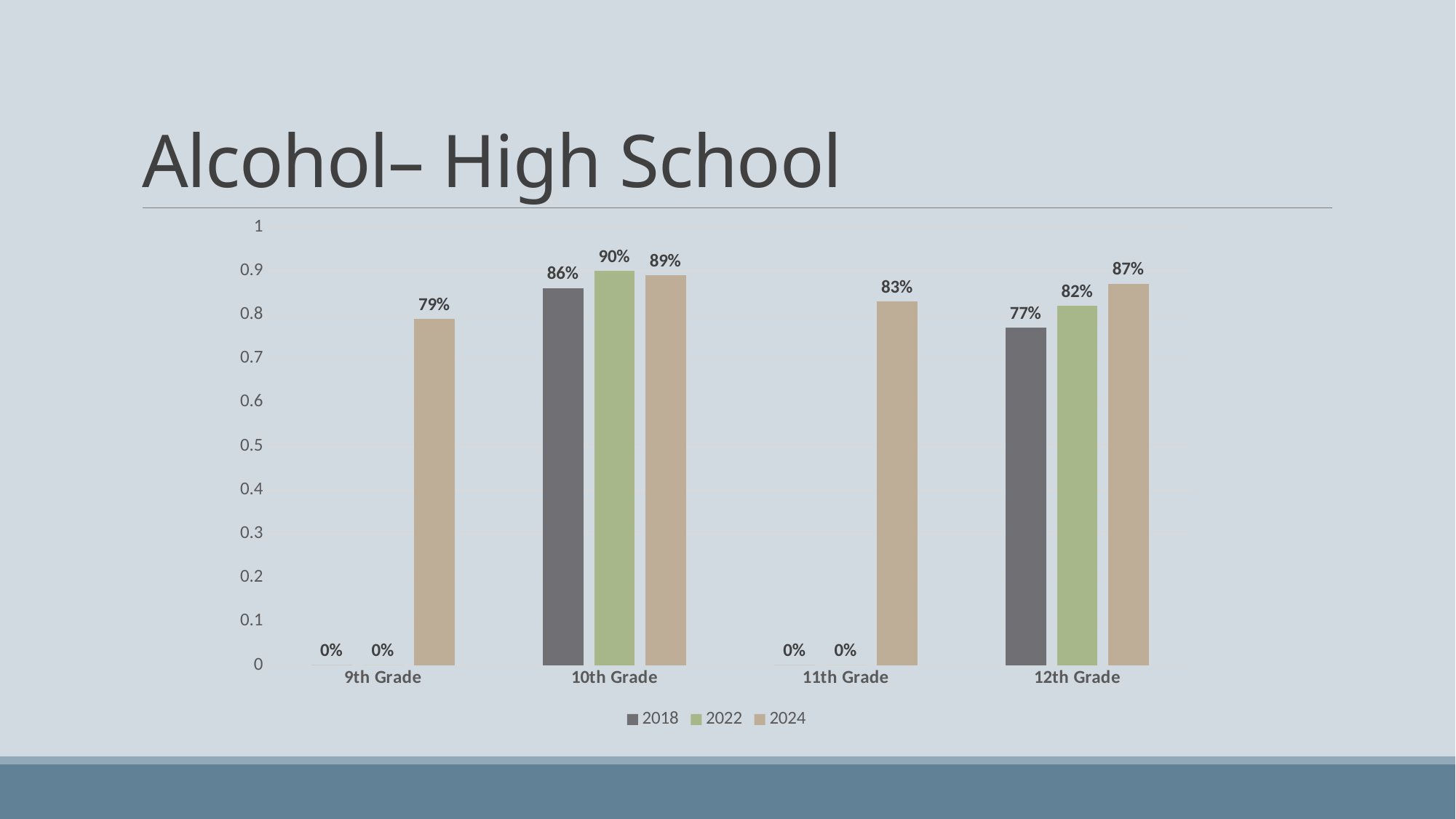
How many series does the legend list? 3 What is the difference between the 2024 values for 10th Grade and 9th Grade? 10% Which grade has the lowest 2024 value? 9th Grade What is the title of the slide? Alcohol– High School How many grade categories are shown on the x axis? 4 What kind of chart is shown on the slide? Bar chart Which grade has the highest 2024 value? 10th Grade What is the 2024 value for 11th Grade? 83% Which is larger for 12th Grade, the 2022 value or the 2024 value? 2024 What is the 2022 value for 10th Grade? 90% What is the 2024 value for 9th Grade? 79% What is the 2018 value for 12th Grade? 77%